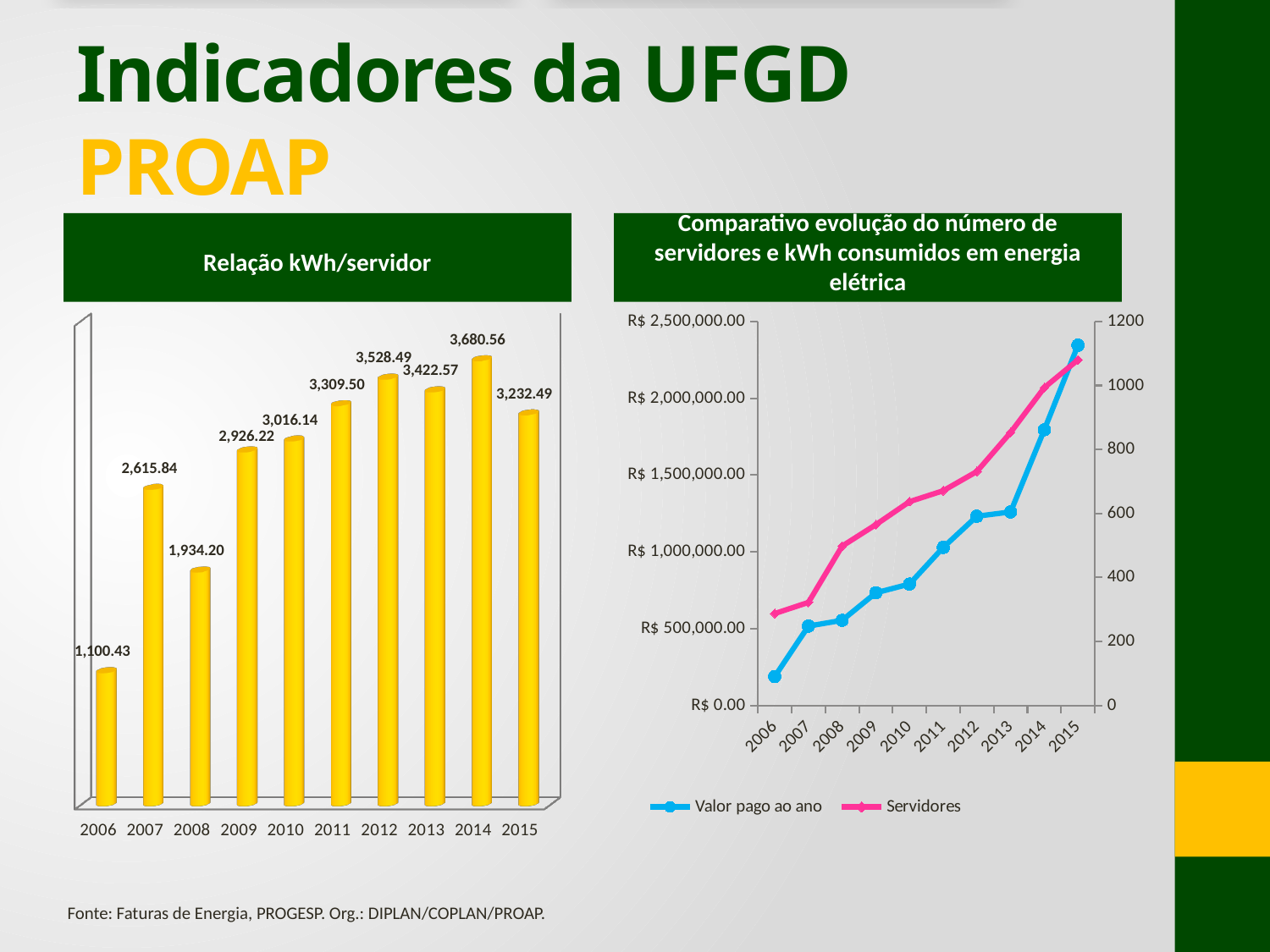
In the 'Comparativo evolução do número de servidores e kWh consumidos em energia elétrica' chart, is the 'Valor pago ao ano' value for 2006 greater or less than R$ 500,000.00? less In the 'Comparativo evolução do número de servidores e kWh consumidos em energia elétrica' chart, does the 'Servidores' line rise or fall from 2006 to 2015? Rises How many years are shown in the 'Relação kWh/servidor' chart? 10 In the 'Relação kWh/servidor' chart, what is the value for 2012? 3,528.49 In the 'Relação kWh/servidor' chart, which year has the highest value? 2014 In the 'Relação kWh/servidor' chart, what is the difference between the 2014 value and the 2006 value? 2,580.13 In the 'Comparativo evolução do número de servidores e kWh consumidos em energia elétrica' chart, is the 'Servidores' value for 2015 greater or less than 1000? greater In the 'Relação kWh/servidor' chart, which year has the lowest value? 2006 How many series does the legend of the 'Comparativo evolução do número de servidores e kWh consumidos em energia elétrica' chart list? 2 In the 'Relação kWh/servidor' chart, what is the value for 2006? 1,100.43 What kind of chart is the 'Relação kWh/servidor' chart? Bar chart In the 'Relação kWh/servidor' chart, which year has the larger value, 2007 or 2008? 2007